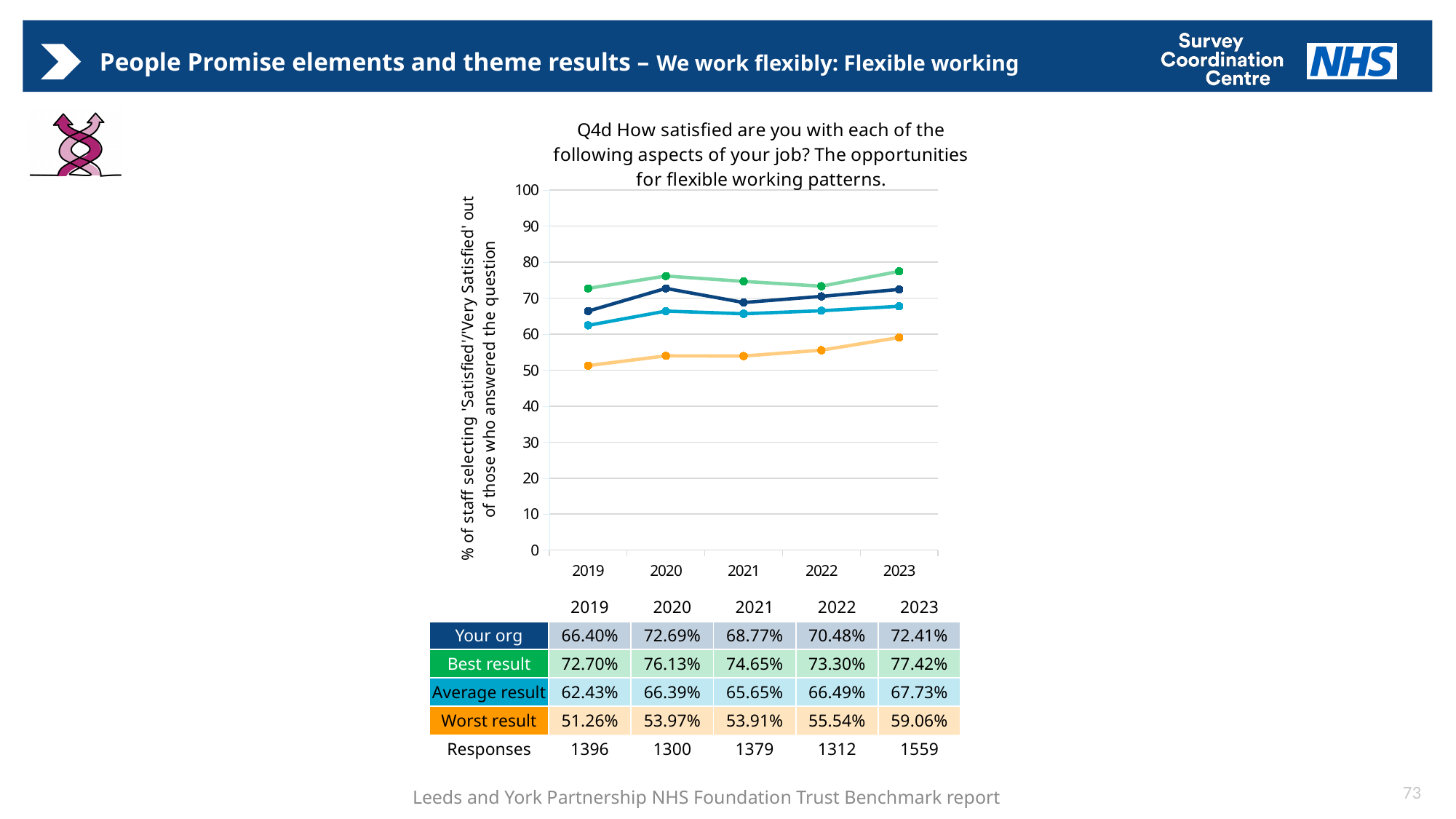
In which year is the Best result series at its highest? 2023 What type of chart is shown on the slide? line chart What is the Worst result value in 2019? 51.26% What is the difference between Your org and Average result in 2021? 3.12% Which is larger in 2022, Your org or Average result? Your org Is the Worst result value for 2023 greater or less than 60? less In which year is the Your org series at its lowest? 2019 How many series are plotted in the chart? 4 Does the Worst result series rise or fall from 2019 to 2023? rise How many years are plotted along the x axis of the chart? 5 What is the Best result value in 2020? 76.13% What is the value for Your org in 2023? 72.41%